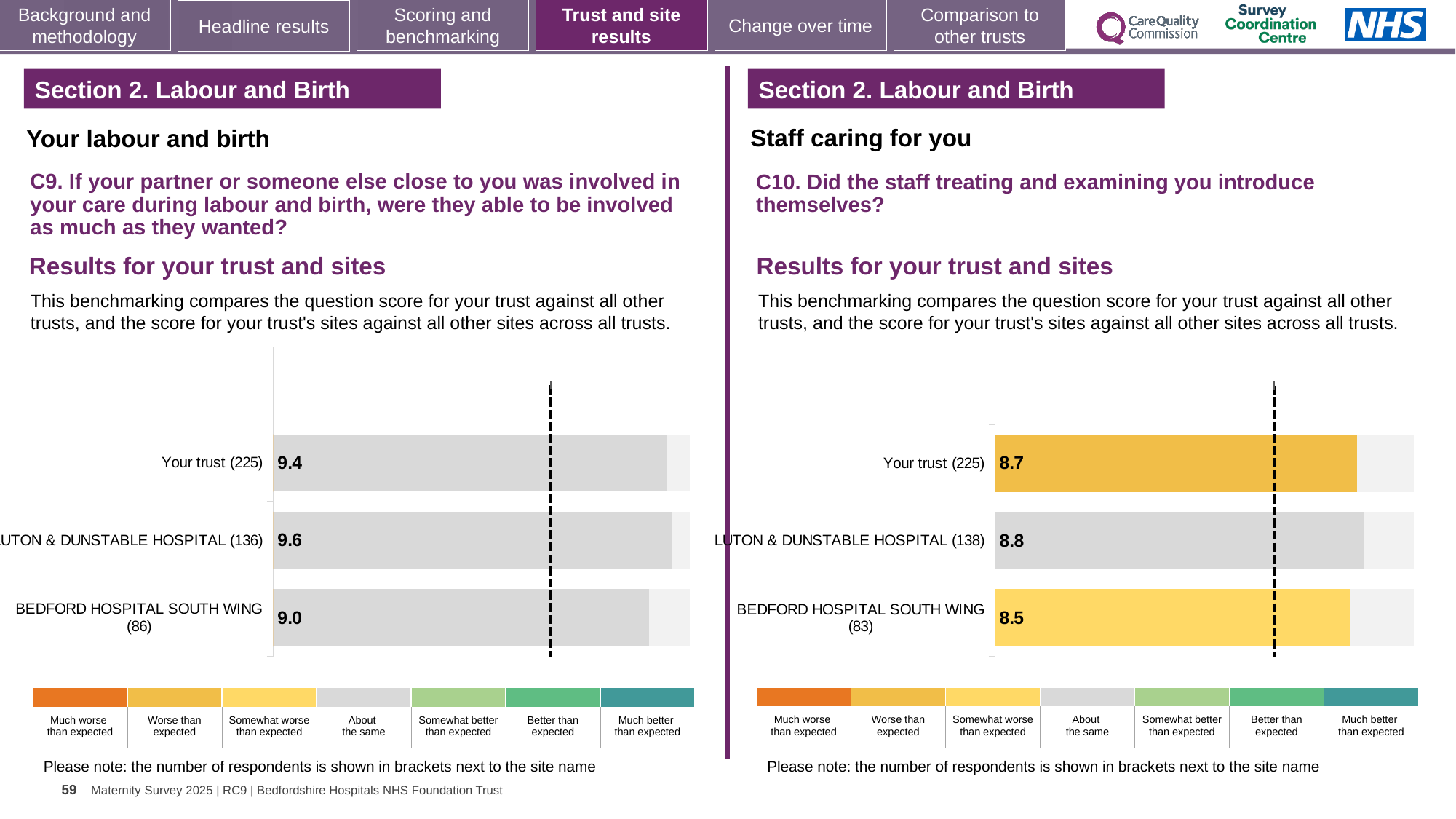
In the C10 chart on the right, what is the score for Your trust? 8.7 In the C9 chart on the left, what is the difference between the Luton & Dunstable Hospital score and the Bedford Hospital South Wing score? 0.6 In the C10 chart on the right, which site or trust has the lowest score? Bedford Hospital South Wing In the C9 chart on the left, what is the score for Bedford Hospital South Wing? 9.0 In the C10 chart on the right, how many respondents are shown in brackets for Bedford Hospital South Wing? 83 In the C9 chart on the left, which site or trust has the highest score? Luton & Dunstable Hospital In the C9 chart on the left, what is the score for Your trust? 9.4 What kind of chart is used in the C9 chart on the left? Bar chart In the C9 chart on the left, how many bars are plotted? 3 In the C10 chart on the right, what is the difference between the Your trust score and the Bedford Hospital South Wing score? 0.2 In the C10 chart on the right, what is the score for Luton & Dunstable Hospital? 8.8 In the C10 chart on the right, is the score for Your trust or for Bedford Hospital South Wing larger? Your trust